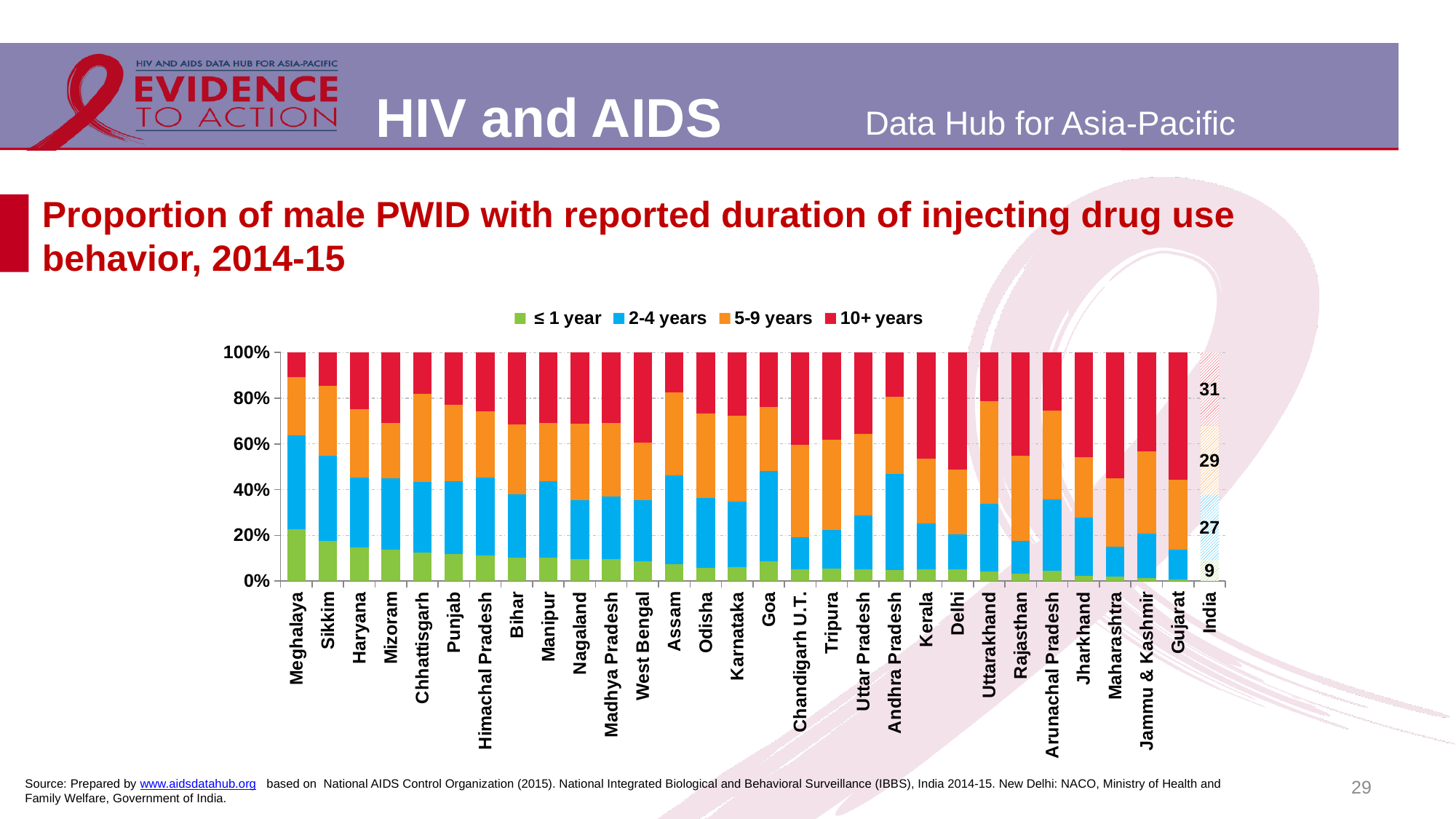
Is the 10+ years share for Delhi greater or less than 40%? greater How many states/territories (including India) are shown on the x axis? 30 What is the labelled value for the 10+ years segment of the India bar? 31 What is the labelled value for the ≤ 1 year segment of the India bar? 9 Which state has the largest ≤ 1 year share? Meghalaya How many series does the legend list? 4 Which state has the smallest 10+ years share? Meghalaya What is the labelled value for the 2-4 years segment of the India bar? 27 Which series is shown in green in the legend? ≤ 1 year Which has the larger ≤ 1 year share, Meghalaya or Gujarat? Meghalaya What is the difference between the 10+ years and ≤ 1 year labelled values for India? 22 What kind of chart is shown on the slide? Stacked bar chart